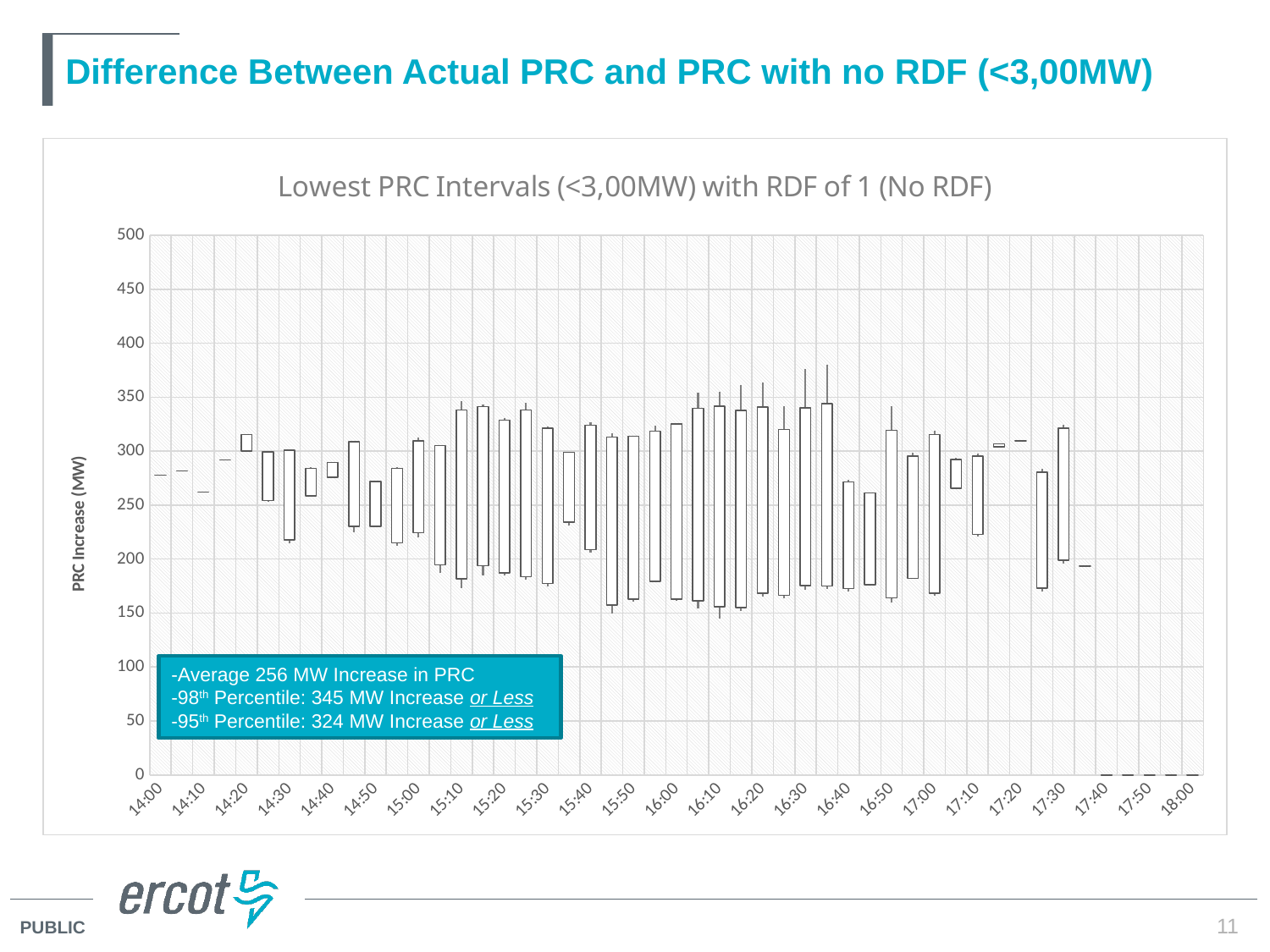
What is the last time label on the horizontal axis? 18:00 Is the value plotted at 17:40 greater or less than 250? less What is the label on the vertical axis of the chart? PRC Increase (MW) What is the first time label on the horizontal axis? 14:00 Is the highest point plotted at 16:30 greater or less than 350? greater According to the text box on the chart, what is the average MW increase in PRC? 256 MW Is the value plotted at 14:00 greater or less than 300? less According to the text box on the chart, what is the 95th percentile MW increase? 324 MW What is the title of the chart? Lowest PRC Intervals (<3,00MW) with RDF of 1 (No RDF) How many time labels are shown along the horizontal axis? 25 What is the maximum value shown on the vertical axis? 500